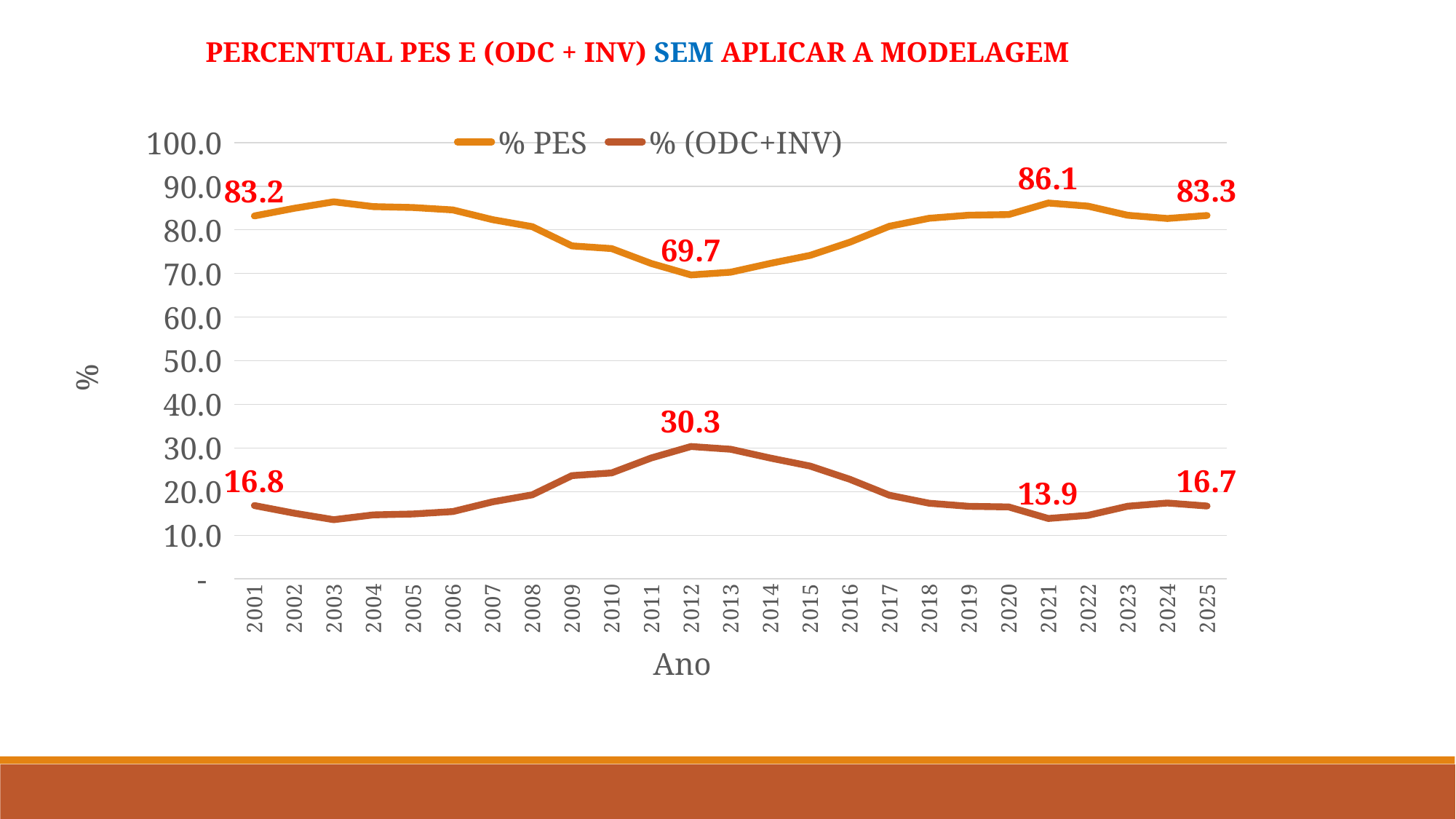
Is the value of % (ODC+INV) in 2009 greater or less than 20.0? greater Which is larger in 2001: the % PES value or the % (ODC+INV) value? % PES What is the value of % (ODC+INV) in 2025? 16.7 How many series does the legend list? 2 What is the label of the x axis? Ano What kind of chart is shown on the slide? Line chart In which year does the % (ODC+INV) series reach its highest labelled value? 2012 What is the difference between the % PES value in 2021 and the % PES value in 2012? 16.4 What is the value of % PES in 2021? 86.1 What is the value of % (ODC+INV) in 2012? 30.3 In which year does the % PES series reach its lowest labelled value? 2012 What is the value of % PES in 2001? 83.2